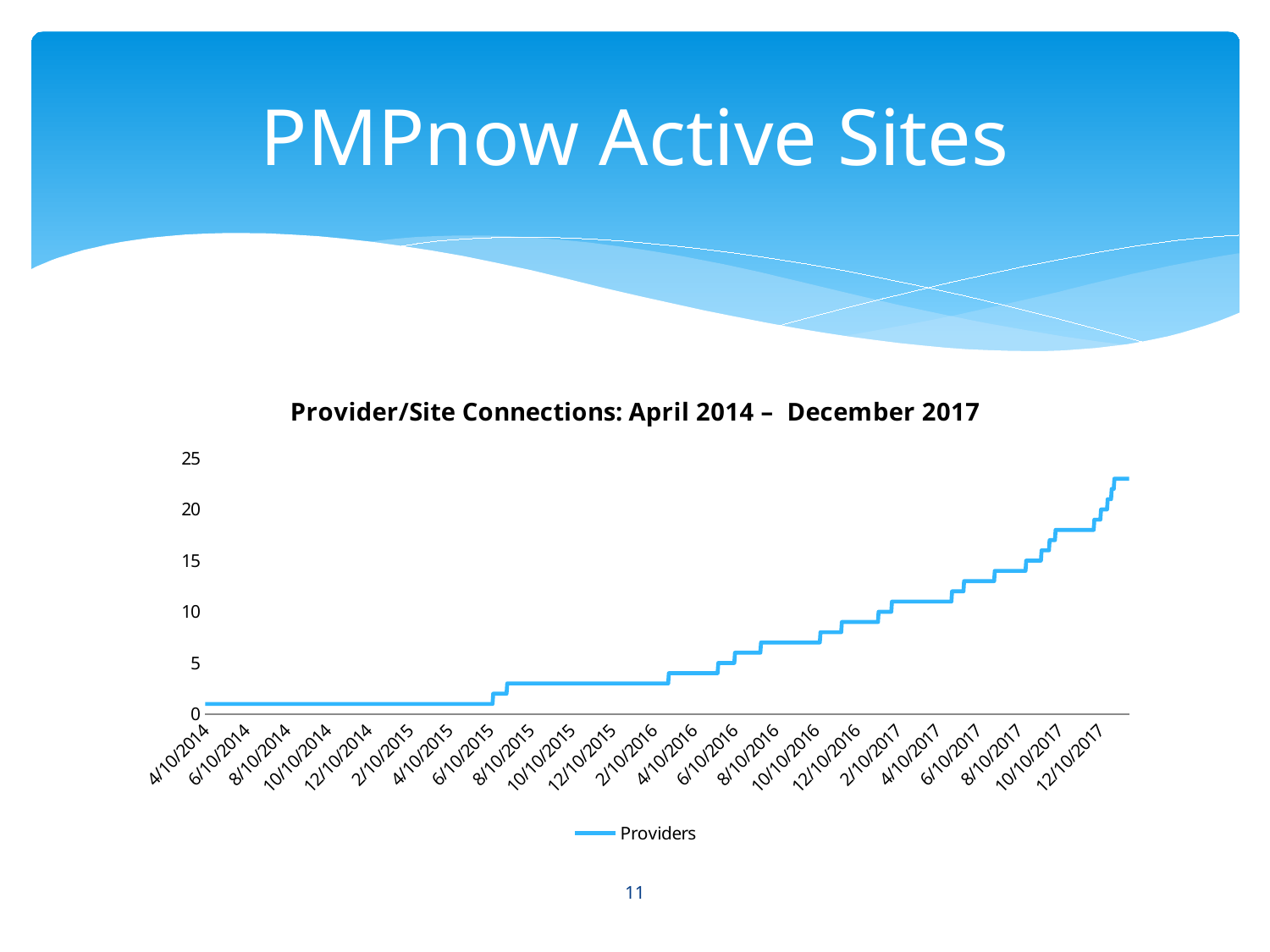
Which is larger, the value for Providers at 4/10/2014 or at 12/10/2017? 12/10/2017 Do the values for Providers rise or fall from April 2014 to December 2017? rise What kind of chart is shown on the slide? line chart Is the value for Providers at 12/10/2017 greater or less than 20? greater Is the value for Providers at 6/10/2017 greater or less than 10? greater Is the value for Providers at 10/10/2015 greater or less than 5? less How many series does the legend list? 1 What is the title of the chart? Provider/Site Connections: April 2014 – December 2017 How many date labels are shown on the x axis? 23 What is the name of the series shown in the legend? Providers